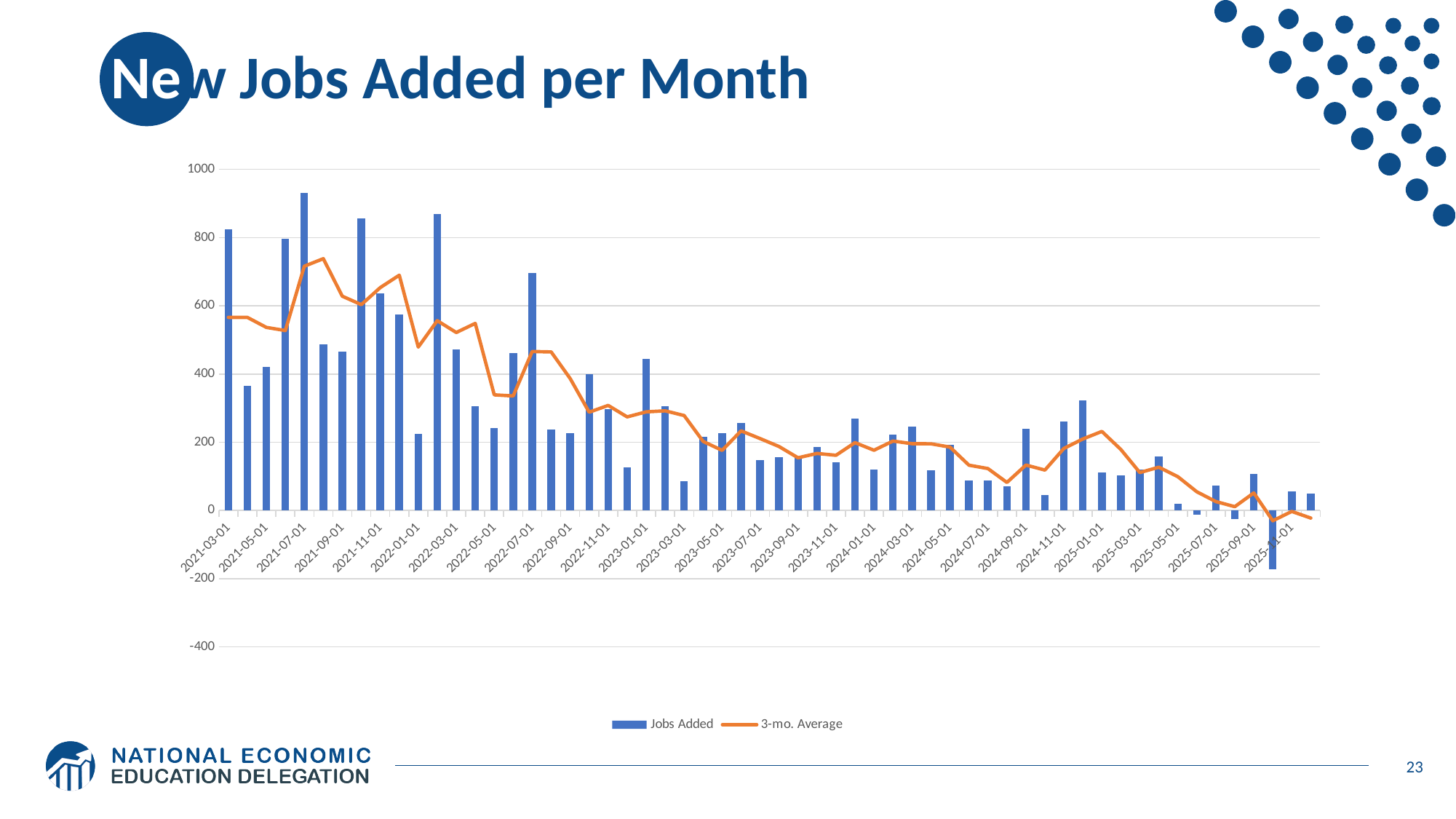
Is the Jobs Added value for 2023-01-01 greater or less than 400? greater Is the Jobs Added value for 2022-07-01 greater or less than 600? greater What colour is the 3-mo. Average line? Orange Is the Jobs Added value for 2025-05-01 greater or less than 200? less Do the Jobs Added values generally rise or fall from 2021 to 2025? Fall Which has the larger Jobs Added value, 2021-03-01 or 2021-05-01? 2021-03-01 What kind of chart is shown on the slide? Bar chart with a line overlay How many series does the legend list? 2 What are the two series named in the legend? Jobs Added and 3-mo. Average Which month has the highest Jobs Added bar? 2021-07-01 Which has the larger Jobs Added value, 2022-07-01 or 2023-07-01? 2022-07-01